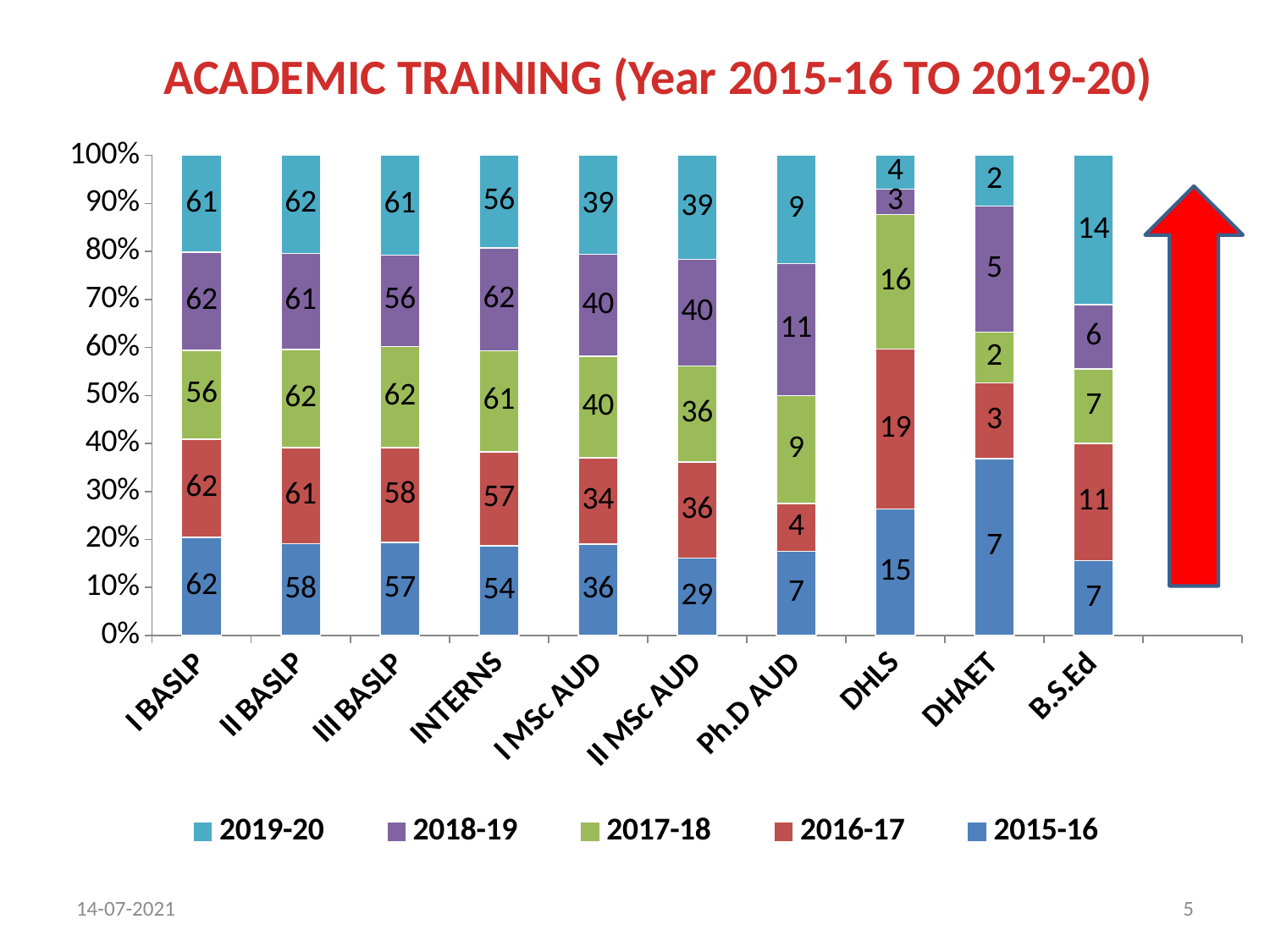
Which category has the lowest value for 2019-20? DHAET What is the value for 2019-20 for B.S.Ed? 14 What is the value for 2018-19 for Ph.D AUD? 11 Which category has the highest value for 2015-16? I BASLP What is the difference between the 2015-16 values for I MSc AUD and II MSc AUD? 7 What is the value for 2015-16 for I BASLP? 62 How many categories are shown on the x axis? 10 What is the value for 2016-17 for DHLS? 19 Which is larger, the 2017-18 value for DHLS or the 2017-18 value for Ph.D AUD? DHLS How many series does the legend list? 5 What kind of chart is shown on the slide? Stacked bar chart What is the total of all five series for DHAET? 19